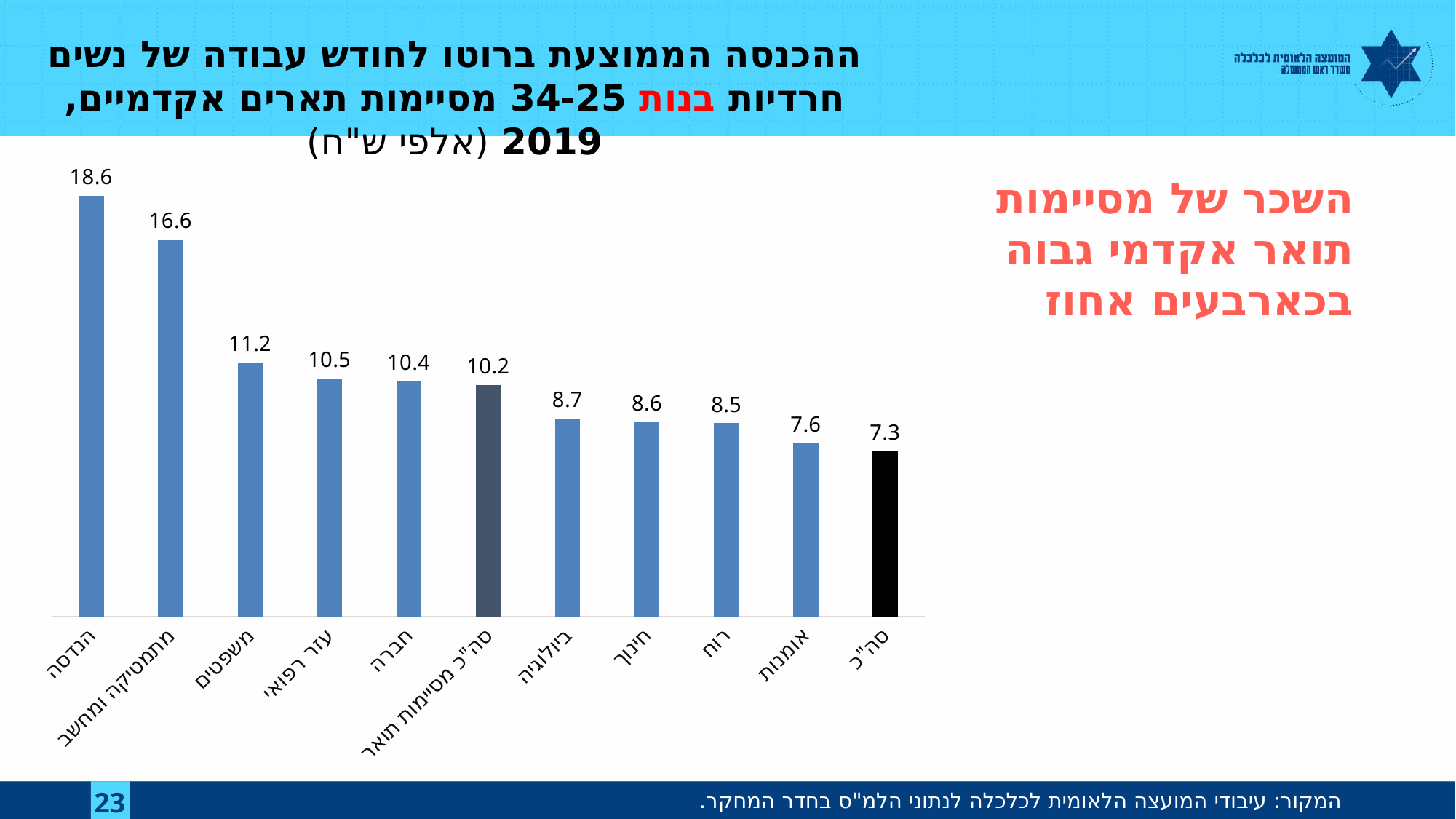
What is the difference between the values for משפטים and אומנות? 3.6 Which category has the highest value? הנדסה What is the difference between the values for הנדסה and מתמטיקה ומחשב? 2.0 What is the value for the סה"כ bar? 7.3 What colour is the סה"כ bar? black What is the value for סה"כ מסיימות תואר? 10.2 Which category has the lowest value? סה"כ What is the value for הנדסה? 18.6 Which is larger, the value for ביולוגיה or the value for אומנות? ביולוגיה How many bars are shown in the chart? 11 What kind of chart is shown on the slide? bar chart What is the value for מתמטיקה ומחשב? 16.6